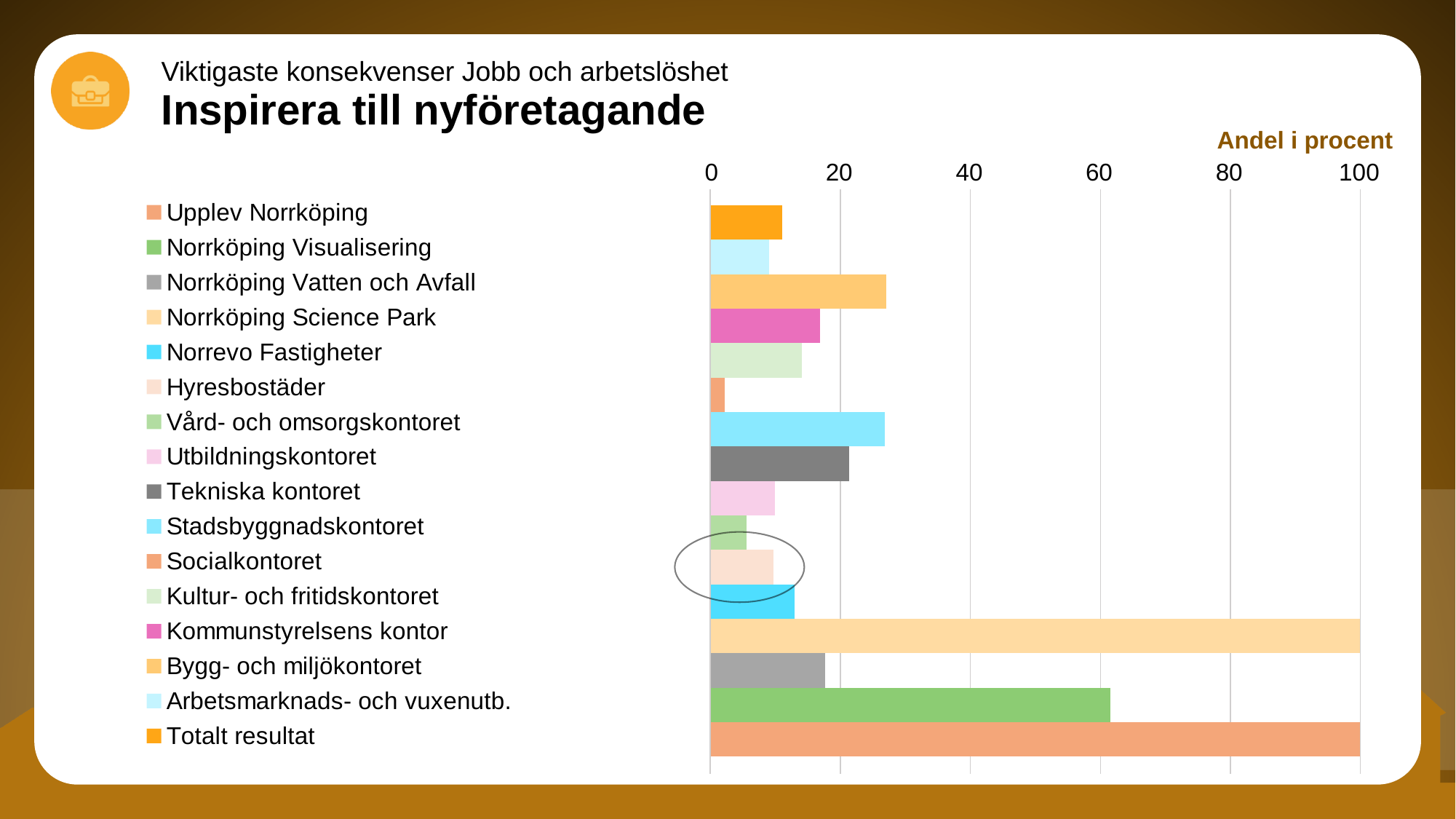
How many series does the legend list? 16 Is the value for Bygg- och miljökontoret greater or less than 20? greater Which is larger, the value for Stadsbyggnadskontoret or the value for Socialkontoret? Stadsbyggnadskontoret Is the value for Kommunstyrelsens kontor greater or less than 20? less Which is larger, the value for Norrköping Visualisering or the value for Tekniska kontoret? Norrköping Visualisering What is the value for Upplev Norrköping? 100 What label is shown above the horizontal axis of the chart? Andel i procent How many bars are plotted in the chart? 16 What is the value for Norrköping Science Park? 100 What kind of chart is shown on the slide? bar chart Which category has the lowest value? Socialkontoret Is the value for Norrköping Visualisering greater or less than 40? greater